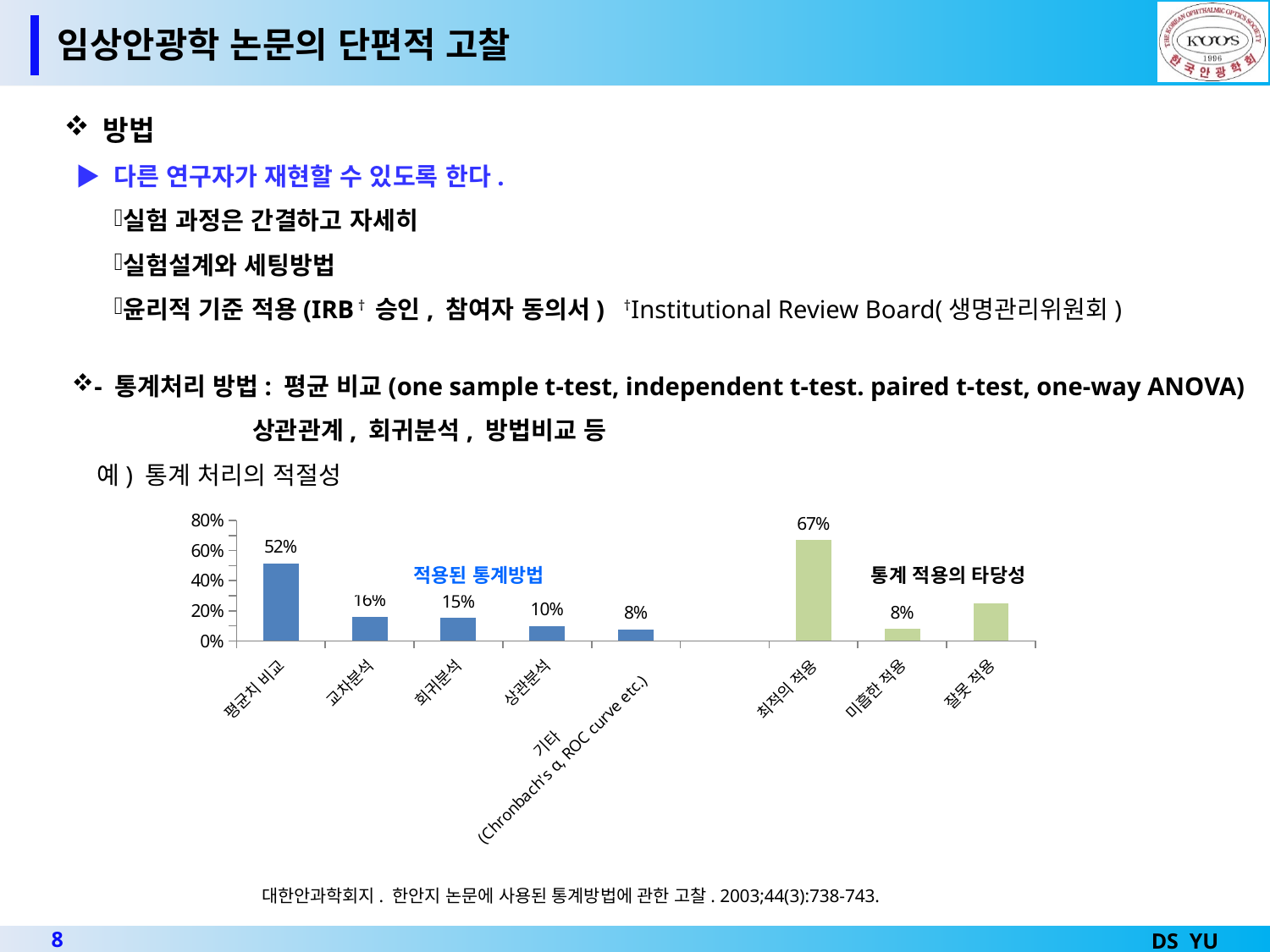
How many bars are plotted in the chart? 8 What kind of chart is shown on the slide? bar chart What is the value for 최적의 적용? 67% What is the value for 미흡한 적용? 8% Among the 적용된 통계방법 bars, which category has the highest value? 평균치 비교 What is the value for 평균치 비교? 52% Which is larger, the value for 회귀분석 or the value for 상관분석? 회귀분석 Is the value for 잘못 적용 greater or less than 40%? less What is the difference between the values for 평균치 비교 and 교차분석? 36% Which category has the highest value in the chart? 최적의 적용 What is the value for 교차분석? 16% What is the difference between the values for 최적의 적용 and 미흡한 적용? 59%